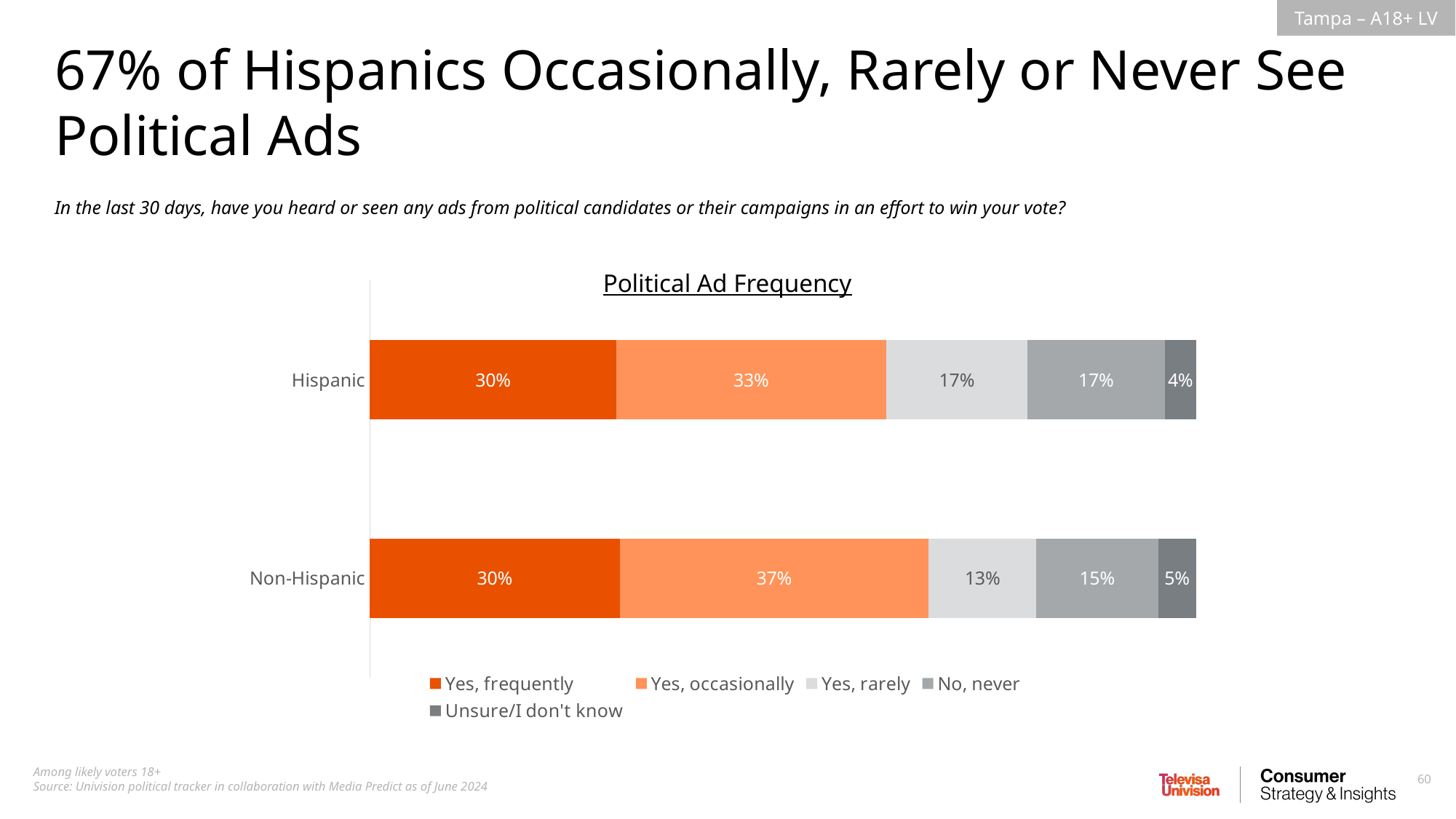
Which response category has the largest share among Non-Hispanic respondents? Yes, occasionally What is the 'No, never' value for Non-Hispanic respondents? 15% How many series does the legend list? 5 What is the 'Unsure/I don't know' value for the Hispanic bar? 4% Which group has a higher 'Yes, rarely' share, Hispanic or Non-Hispanic? Hispanic What type of chart is shown on the slide? Stacked bar chart What percentage of Non-Hispanic respondents said 'Yes, rarely'? 13% Which response category has the smallest share among Hispanic respondents? Unsure/I don't know How many groups (bars) are shown in the chart? 2 What percentage of Hispanic respondents said 'Yes, occasionally'? 33% What is the title of the chart? Political Ad Frequency What is the difference between the 'Yes, occasionally' values for Non-Hispanic and Hispanic respondents? 4%